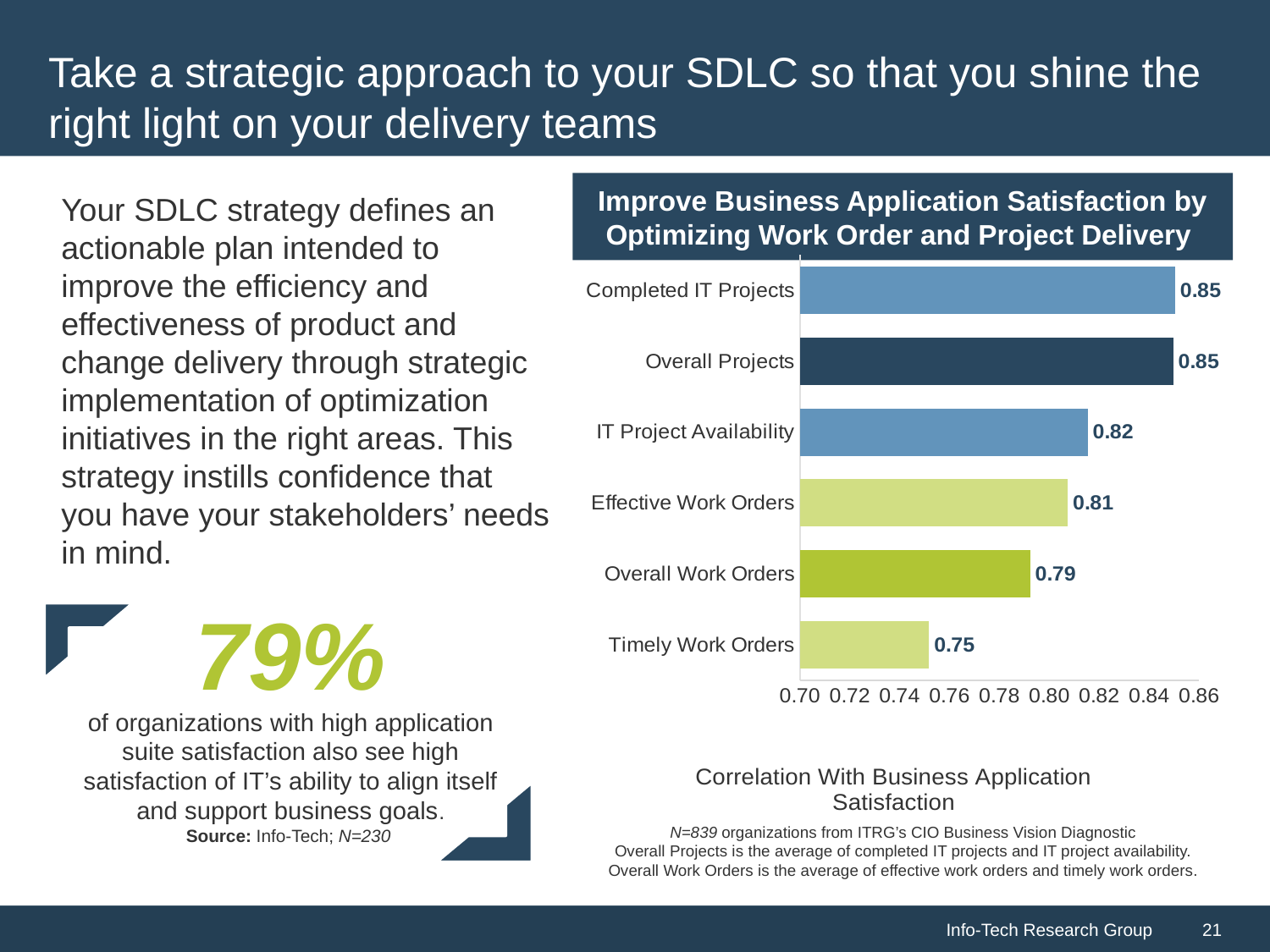
What is the title of the chart? Improve Business Application Satisfaction by Optimizing Work Order and Project Delivery What kind of chart is shown on the slide? bar chart How many categories are shown in the chart? 6 Which is larger, the value for Effective Work Orders or the value for Overall Work Orders? Effective Work Orders Which category has the lowest correlation value? Timely Work Orders What is the correlation value for IT Project Availability? 0.82 Is the value for Overall Work Orders greater or less than 0.80? less What is the correlation value for Timely Work Orders? 0.75 What is the difference between the values for IT Project Availability and Timely Work Orders? 0.07 What is the correlation value for Effective Work Orders? 0.81 What is the difference between the values for Overall Projects and Overall Work Orders? 0.06 What is the correlation value for Completed IT Projects? 0.85